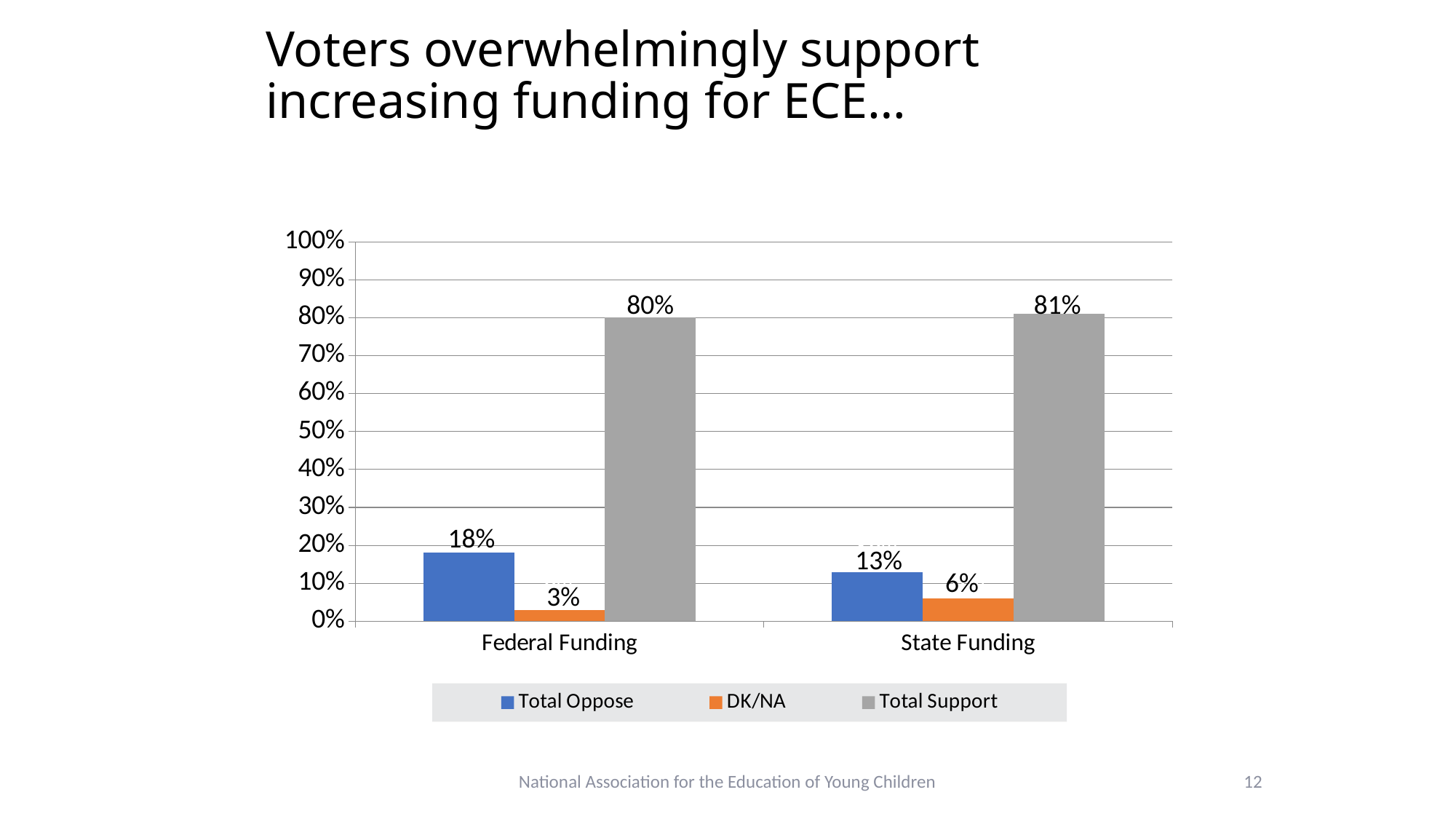
What is the Total Support value for Federal Funding? 80% How many categories are shown on the x axis? 2 What is the DK/NA value for Federal Funding? 3% Is the Total Oppose value for Federal Funding greater or less than 20%? less What kind of chart is shown on the slide? Bar chart How many series does the legend list? 3 Is Total Support larger for Federal Funding or State Funding? State Funding What is the Total Oppose value for State Funding? 13% What is the DK/NA value for State Funding? 6% What is the difference between Total Oppose for Federal Funding and Total Oppose for State Funding? 5% Which series has the lowest value for Federal Funding? DK/NA Which series has the highest value for State Funding? Total Support